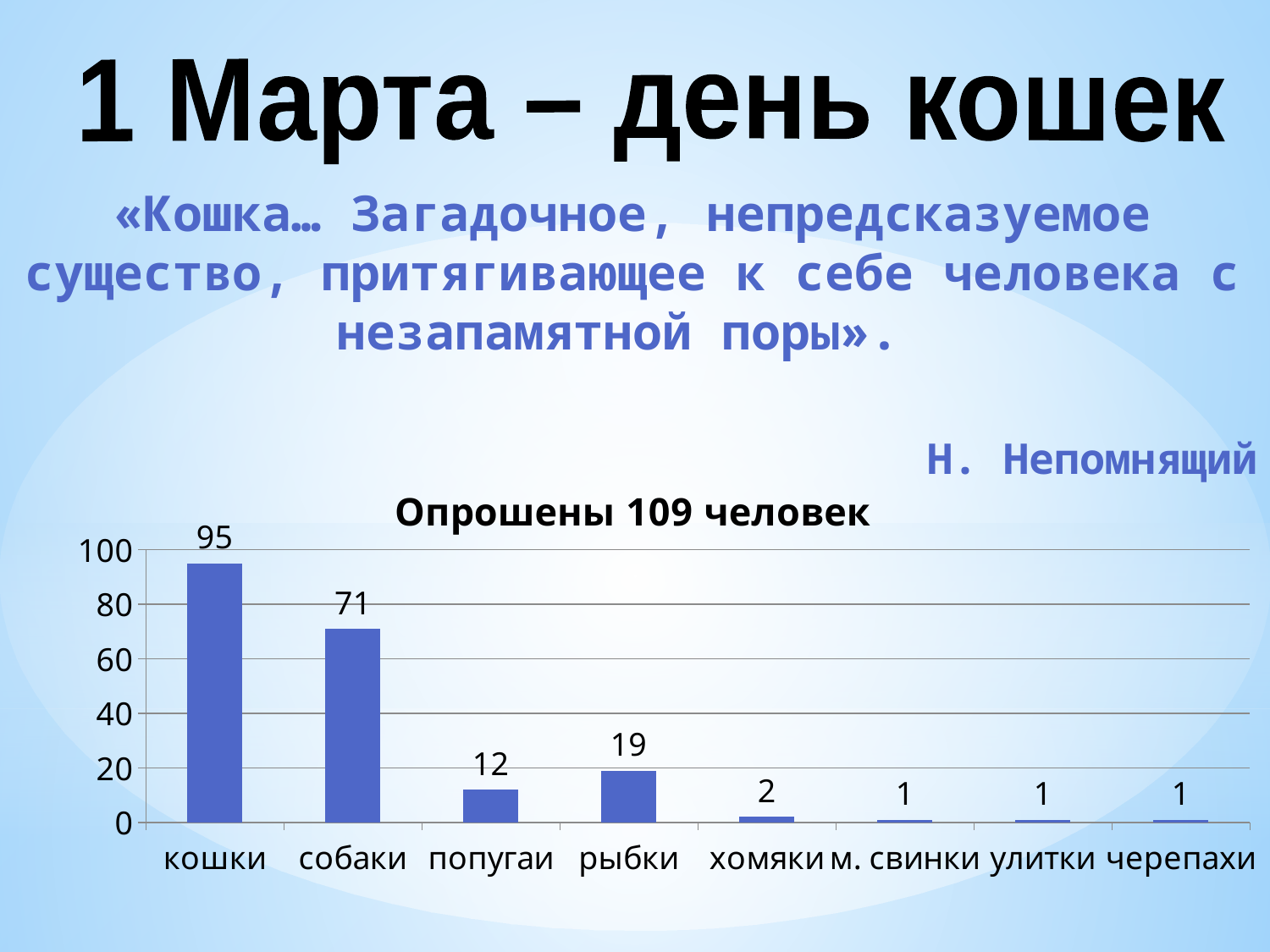
What is the value for хомяки? 2 What is the title of the chart? Опрошены 109 человек What is the value for собаки? 71 Which is larger, the value for попугаи or the value for рыбки? рыбки Is the value for собаки greater or less than 60? greater What is the difference between the values for кошки and собаки? 24 What is the value for кошки? 95 What is the value for попугаи? 12 How many categories are shown on the x axis? 8 What kind of chart is shown on the slide? bar chart Which category has the highest value? кошки What is the value for рыбки? 19